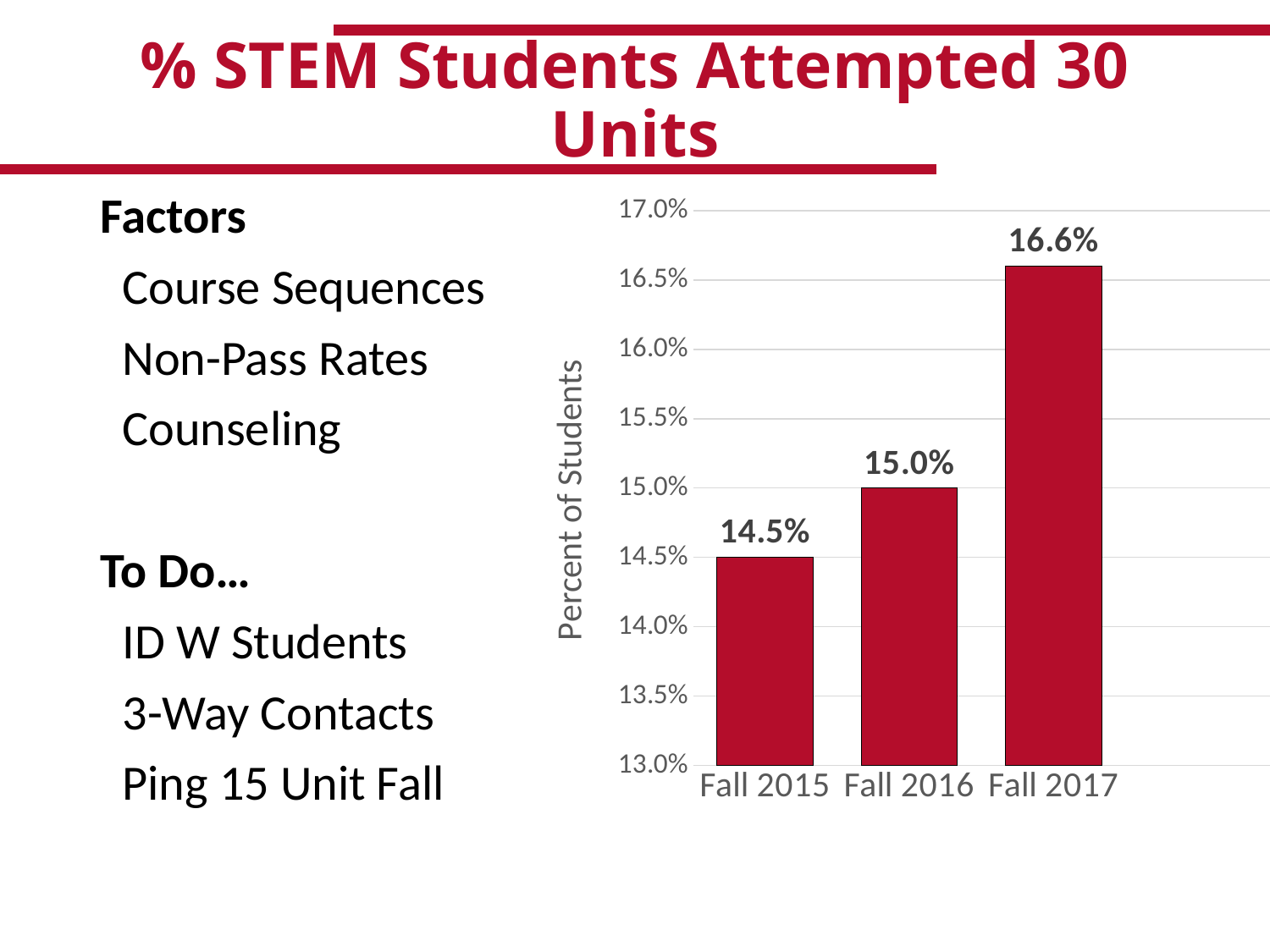
Do the values rise or fall from Fall 2015 to Fall 2017? rise What is the value for Fall 2017? 16.6% Which term has the lowest percent of students? Fall 2015 What is the value for Fall 2015? 14.5% What kind of chart is shown on the slide? bar chart What is the difference between the values for Fall 2017 and Fall 2015? 2.1% Which is larger, the value for Fall 2016 or the value for Fall 2017? Fall 2017 What is the value for Fall 2016? 15.0% How many terms are shown on the x axis? 3 Is the value for Fall 2017 greater or less than 16.0%? greater What is the difference between the values for Fall 2016 and Fall 2015? 0.5% Which term has the highest percent of students? Fall 2017